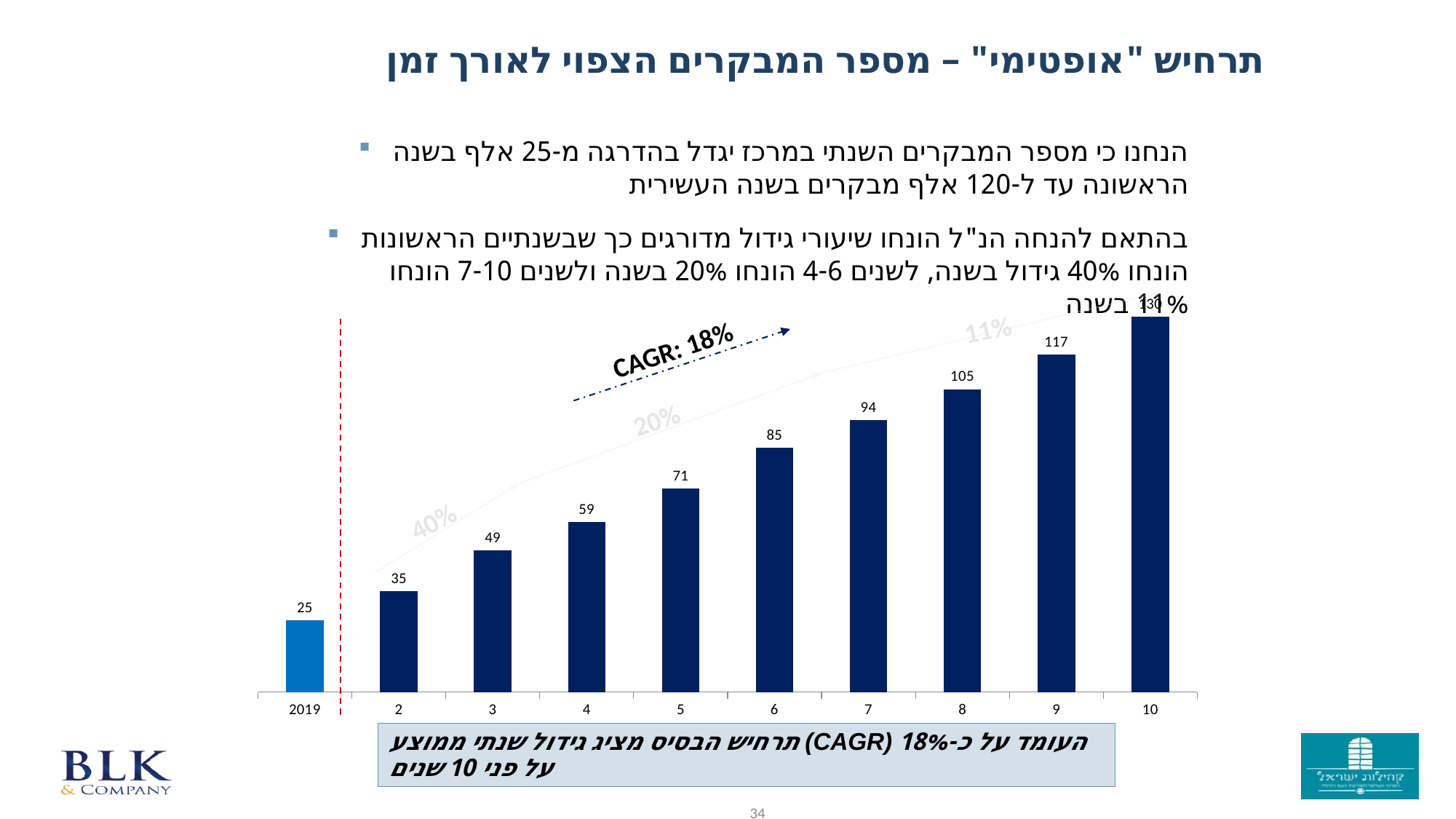
Which is larger, the value for category 7 or the value for category 6? category 7 What is the value for the 2019 bar? 25 What is the value for category 8? 105 What is the difference between the values for category 9 and category 2? 82 What is the difference between the values for category 6 and category 4? 26 What type of chart is shown on the slide? bar chart What is the value for category 3? 49 Do the values rise or fall from left to right along the x axis? rise Which category has the lowest value? 2019 How many bars are plotted in the chart? 10 What is the value for category 5? 71 Which category has the highest bar? 10